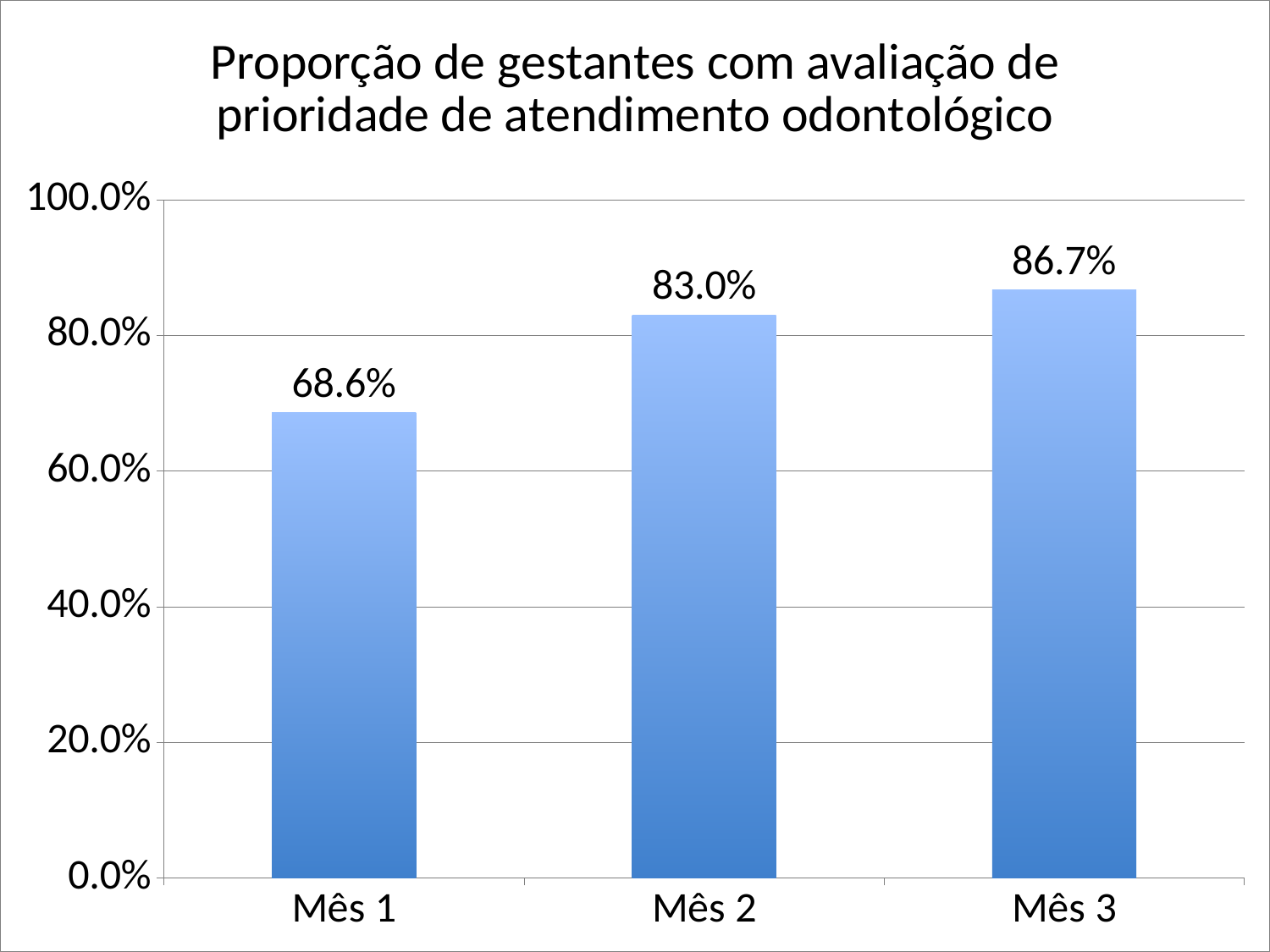
How many categories are shown on the x axis? 3 Which month has the highest value? Mês 3 Do the values rise or fall from Mês 1 to Mês 3? rise What is the value for Mês 2? 83.0% What is the value for Mês 3? 86.7% Is the value for Mês 1 greater or less than 80.0%? less Which month has the lowest value? Mês 1 What is the difference between the values for Mês 3 and Mês 1? 18.1% What is the difference between the values for Mês 2 and Mês 1? 14.4% Which is larger, the value for Mês 1 or the value for Mês 2? Mês 2 What kind of chart is this? bar chart What is the value for Mês 1? 68.6%